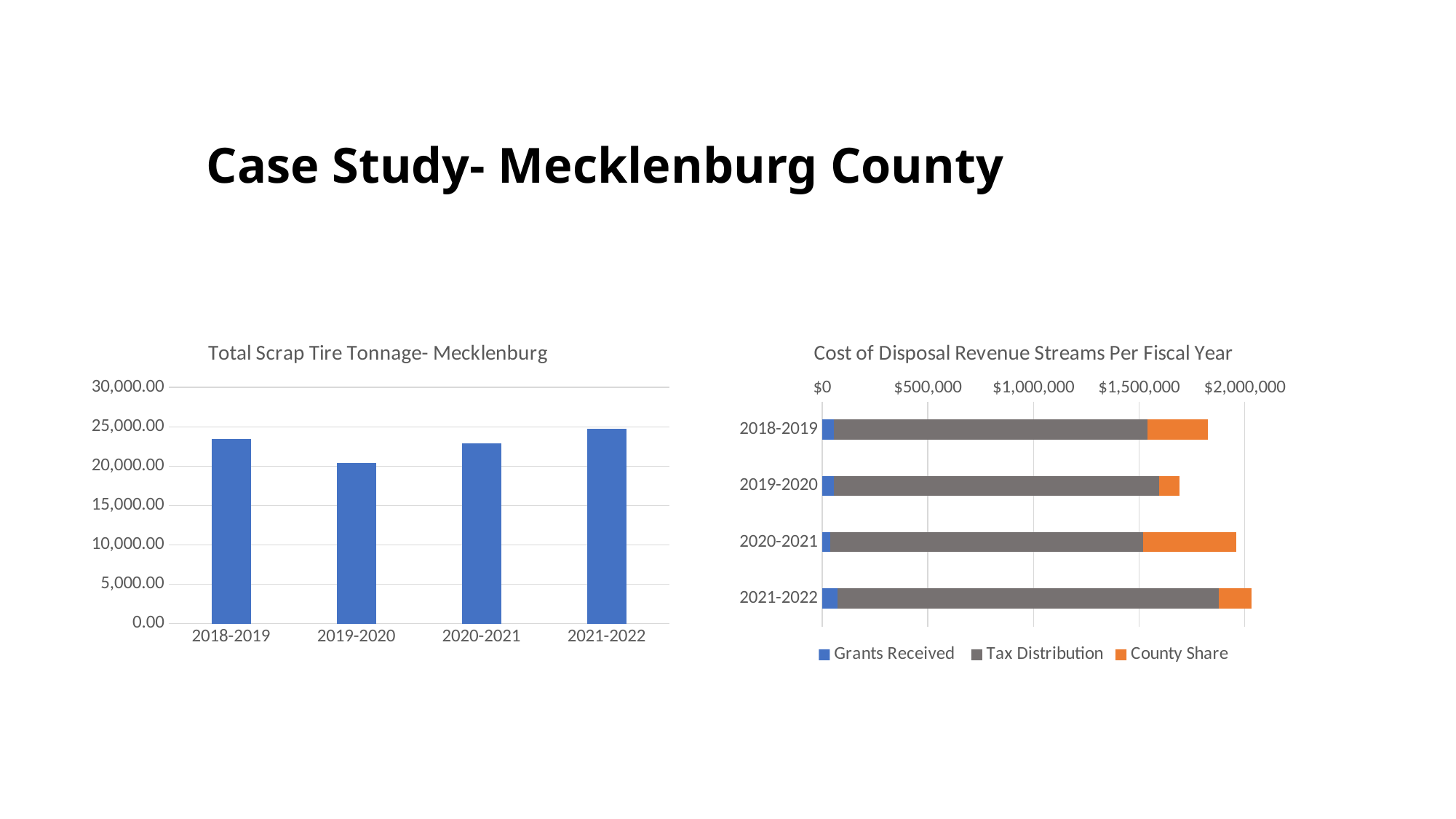
On the 'Cost of Disposal Revenue Streams Per Fiscal Year' chart, which series is shown in orange? County Share What kind of chart is the 'Total Scrap Tire Tonnage- Mecklenburg' chart? bar chart On the 'Cost of Disposal Revenue Streams Per Fiscal Year' chart, which fiscal year has the largest County Share segment? 2020-2021 On the 'Total Scrap Tire Tonnage- Mecklenburg' chart, is the value for 2018-2019 greater or less than 20,000.00? greater On the 'Total Scrap Tire Tonnage- Mecklenburg' chart, is the value for 2019-2020 greater or less than 25,000.00? less On the 'Cost of Disposal Revenue Streams Per Fiscal Year' chart, which fiscal year has the smallest total bar? 2019-2020 On the 'Total Scrap Tire Tonnage- Mecklenburg' chart, which fiscal year has the highest tonnage? 2021-2022 What kind of chart is the 'Cost of Disposal Revenue Streams Per Fiscal Year' chart? stacked bar chart How many fiscal years are shown on the 'Total Scrap Tire Tonnage- Mecklenburg' chart? 4 On the 'Total Scrap Tire Tonnage- Mecklenburg' chart, which fiscal year has the lowest tonnage? 2019-2020 How many series does the legend of the 'Cost of Disposal Revenue Streams Per Fiscal Year' chart list? 3 On the 'Total Scrap Tire Tonnage- Mecklenburg' chart, which is larger, the tonnage for 2018-2019 or for 2019-2020? 2018-2019